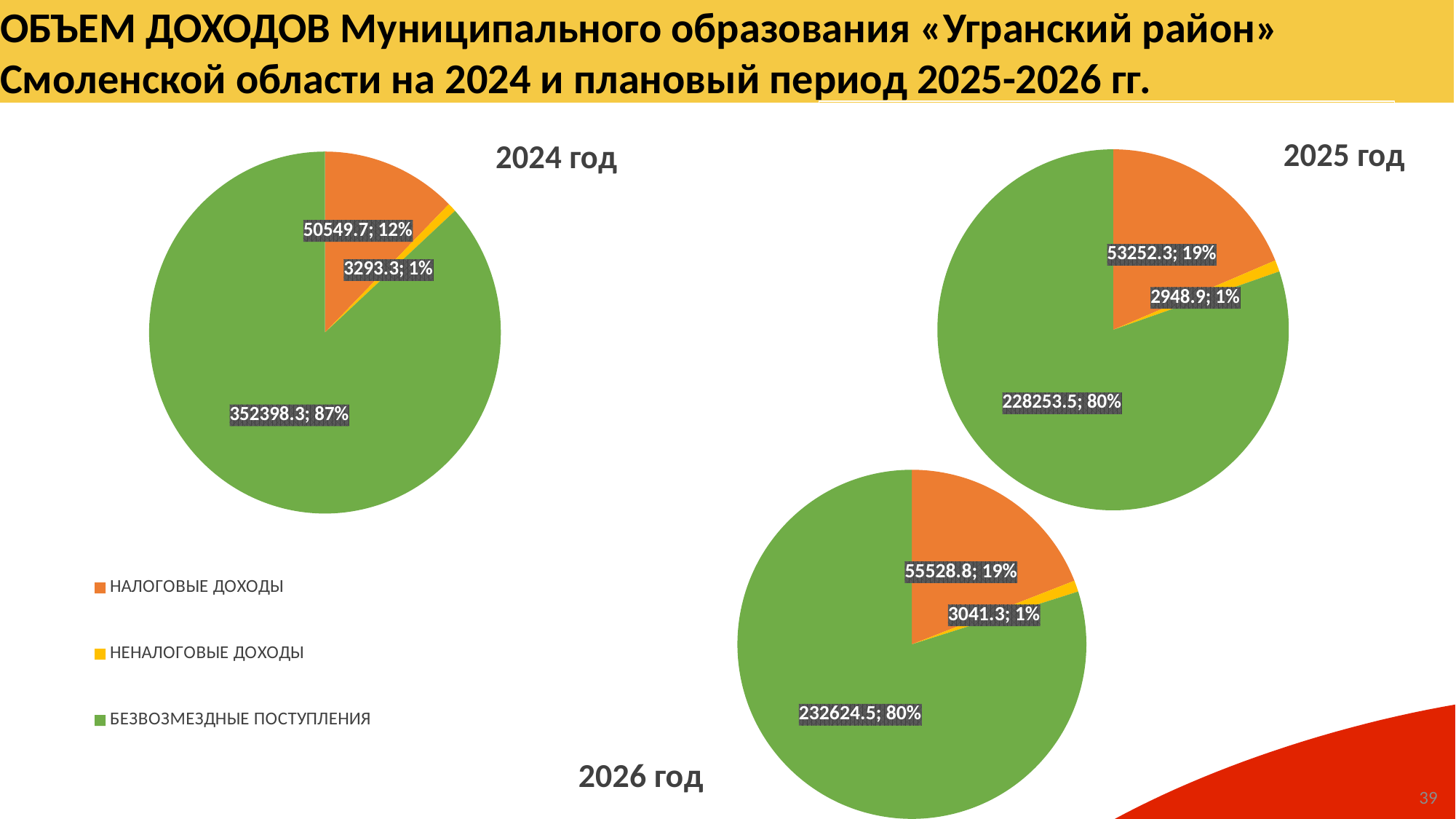
In the 2025 год chart, what share of the pie is НАЛОГОВЫЕ ДОХОДЫ? 19% Which is larger: НАЛОГОВЫЕ ДОХОДЫ in the 2025 год chart or in the 2026 год chart? 2026 год In the 2024 год chart, what is the value for НАЛОГОВЫЕ ДОХОДЫ? 50549.7 In the 2026 год chart, what is the difference between НАЛОГОВЫЕ ДОХОДЫ and НЕНАЛОГОВЫЕ ДОХОДЫ? 52487.5 In the 2024 год chart, which category has the largest slice? БЕЗВОЗМЕЗДНЫЕ ПОСТУПЛЕНИЯ In the 2026 год chart, which category has the smallest slice? НЕНАЛОГОВЫЕ ДОХОДЫ In the 2025 год chart, what is the value for НЕНАЛОГОВЫЕ ДОХОДЫ? 2948.9 In the 2026 год chart, what is the value for БЕЗВОЗМЕЗДНЫЕ ПОСТУПЛЕНИЯ? 232624.5 In the 2024 год chart, what share of the pie is БЕЗВОЗМЕЗДНЫЕ ПОСТУПЛЕНИЯ? 87% Which colour represents НЕНАЛОГОВЫЕ ДОХОДЫ in the legend? Yellow How many categories does the legend list? 3 What kind of charts are shown on the slide? Pie charts